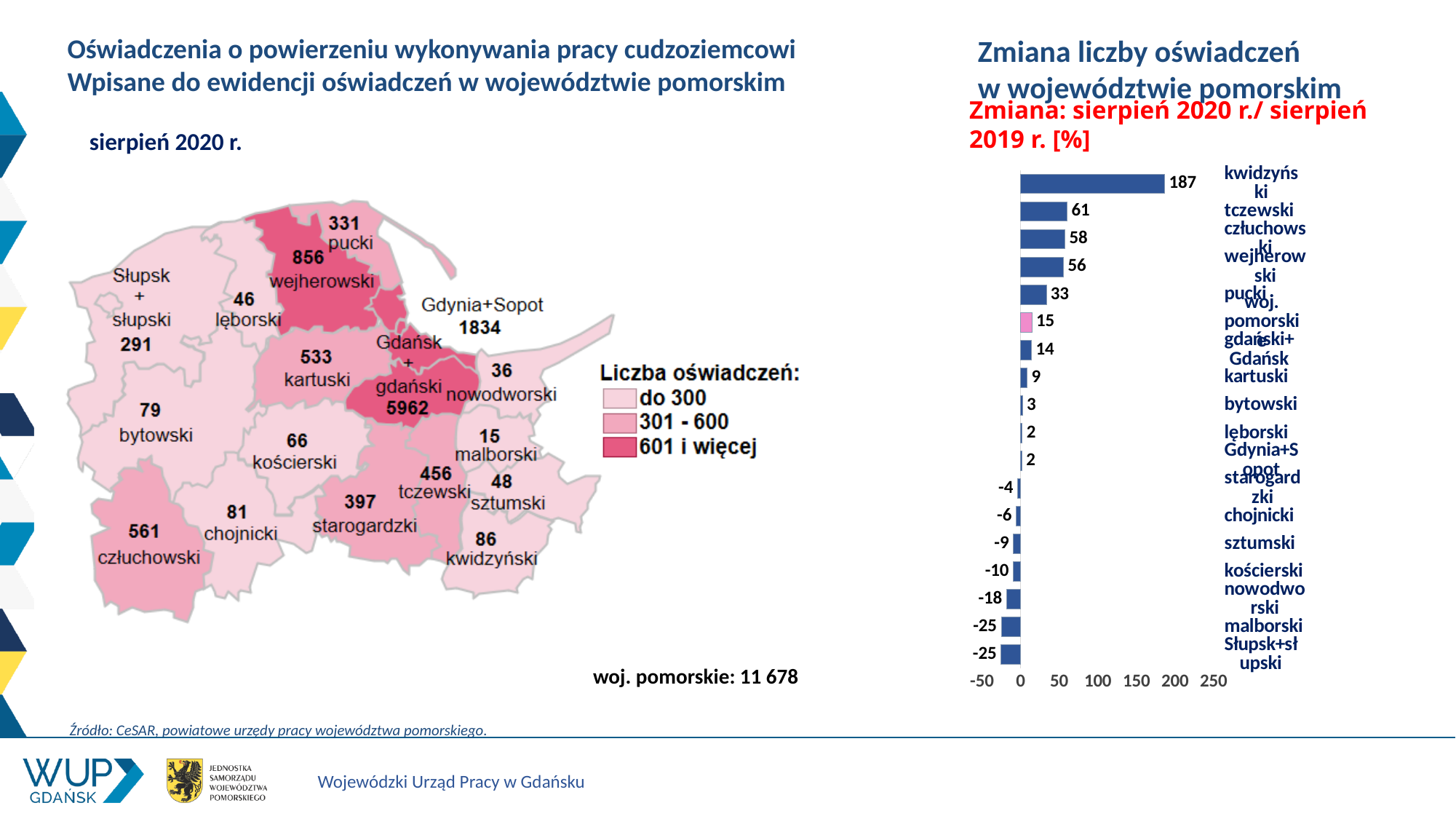
In the bar chart on the right, what is the value for woj. pomorskie? 15 In the bar chart on the right, which category has the highest value? kwidzyński In the bar chart on the right, what is the value for nowodworski? -18 In the bar chart on the right, what is the value for kwidzyński? 187 On the map on the left, what is the number of oświadczenia shown for Gdańsk + gdański? 5962 In the bar chart on the right, which has the larger value, człuchowski or wejherowski? człuchowski What kind of chart is the chart on the right of the slide, titled 'Zmiana liczby oświadczeń w województwie pomorskim'? bar chart In the bar chart on the right, is the value for kwidzyński greater or less than 150? greater How many bars are shown in the bar chart on the right? 18 In the bar chart on the right, what is the difference between the values for kwidzyński and tczewski? 126 In the bar chart on the right, which category's bar is coloured pink instead of blue? woj. pomorskie In the bar chart on the right, what is the value for tczewski? 61